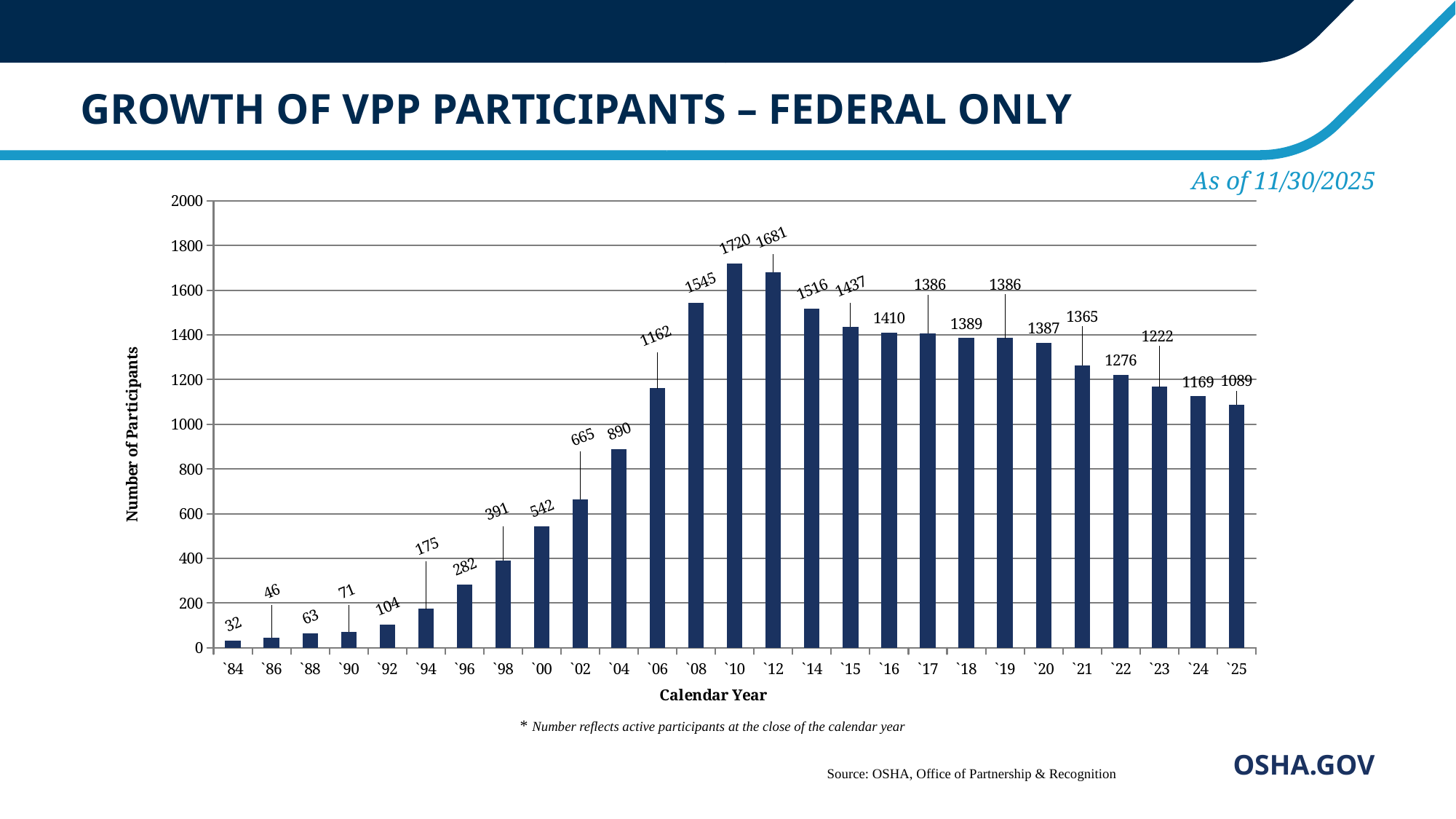
How many calendar years are shown on the x axis? 27 Which calendar year has the highest number of participants? `10 What is the difference in participants between `24 and `25? 80 Is the value for `06 greater or less than 1200? less How many participants are shown for calendar year `10? 1720 Which calendar year has the lowest number of participants? `84 What is the number of participants for `25? 1089 What is the number of participants for `84? 32 Which year has more participants, `08 or `14? `08 What type of chart is shown on the slide? bar chart What is the difference in participants between `10 and `12? 39 What is the title of the chart on the slide? GROWTH OF VPP PARTICIPANTS – FEDERAL ONLY